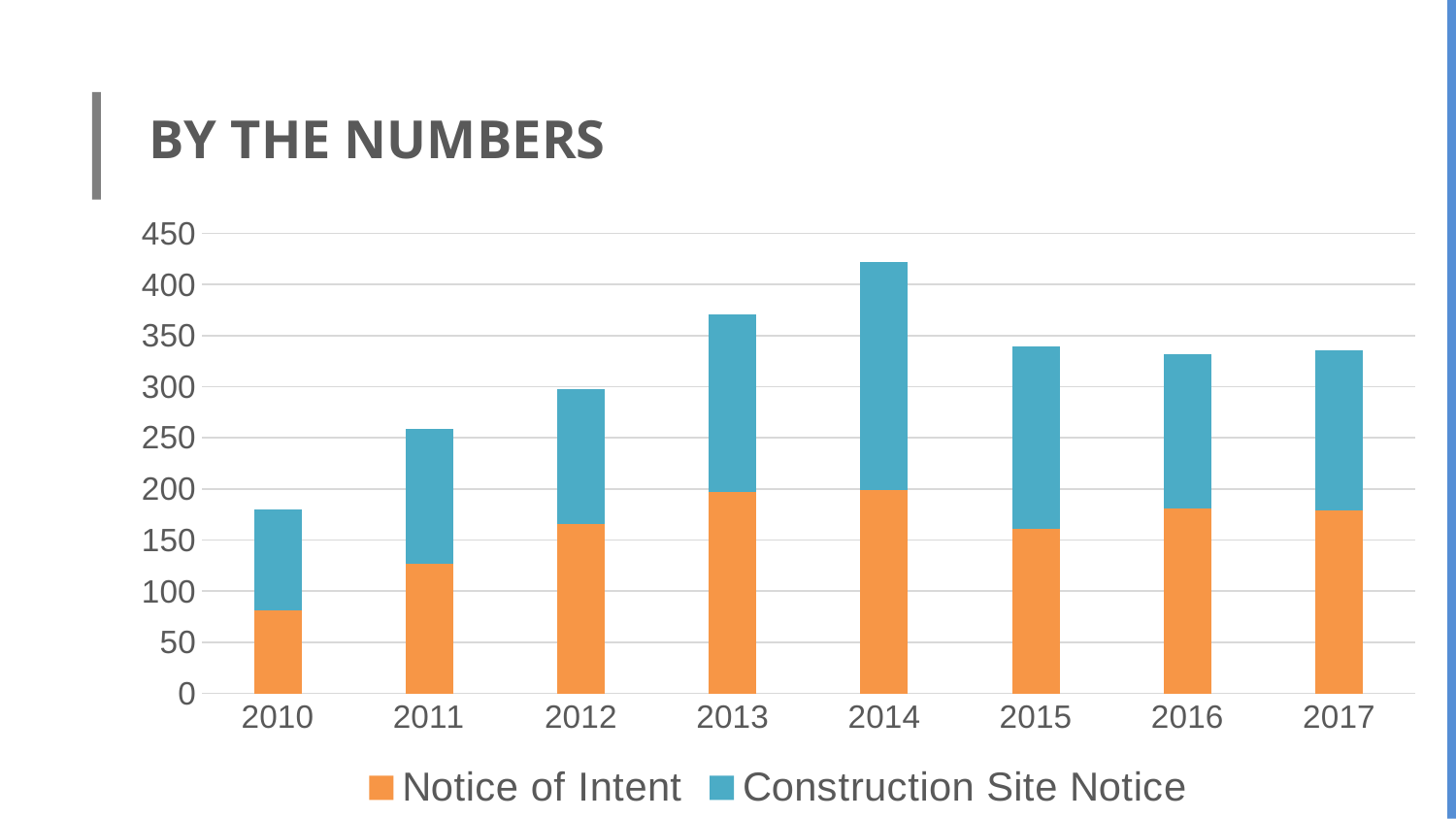
Do the total stacked values rise or fall from 2010 to 2014? rise What kind of chart is shown on the slide? stacked bar chart Which year has the tallest stacked bar overall? 2014 Is the Notice of Intent value for 2010 greater or less than 100? less How many years are shown on the x axis of the chart? 8 Is the total stacked value for 2014 greater or less than 400? greater Which year has the shortest stacked bar overall? 2010 Which year has the smallest Notice of Intent value? 2010 How many series does the chart's legend list? 2 Is the total stacked value for 2010 greater or less than 200? less Which series is shown in orange in the chart? Notice of Intent Which year has the larger total stacked bar, 2011 or 2013? 2013